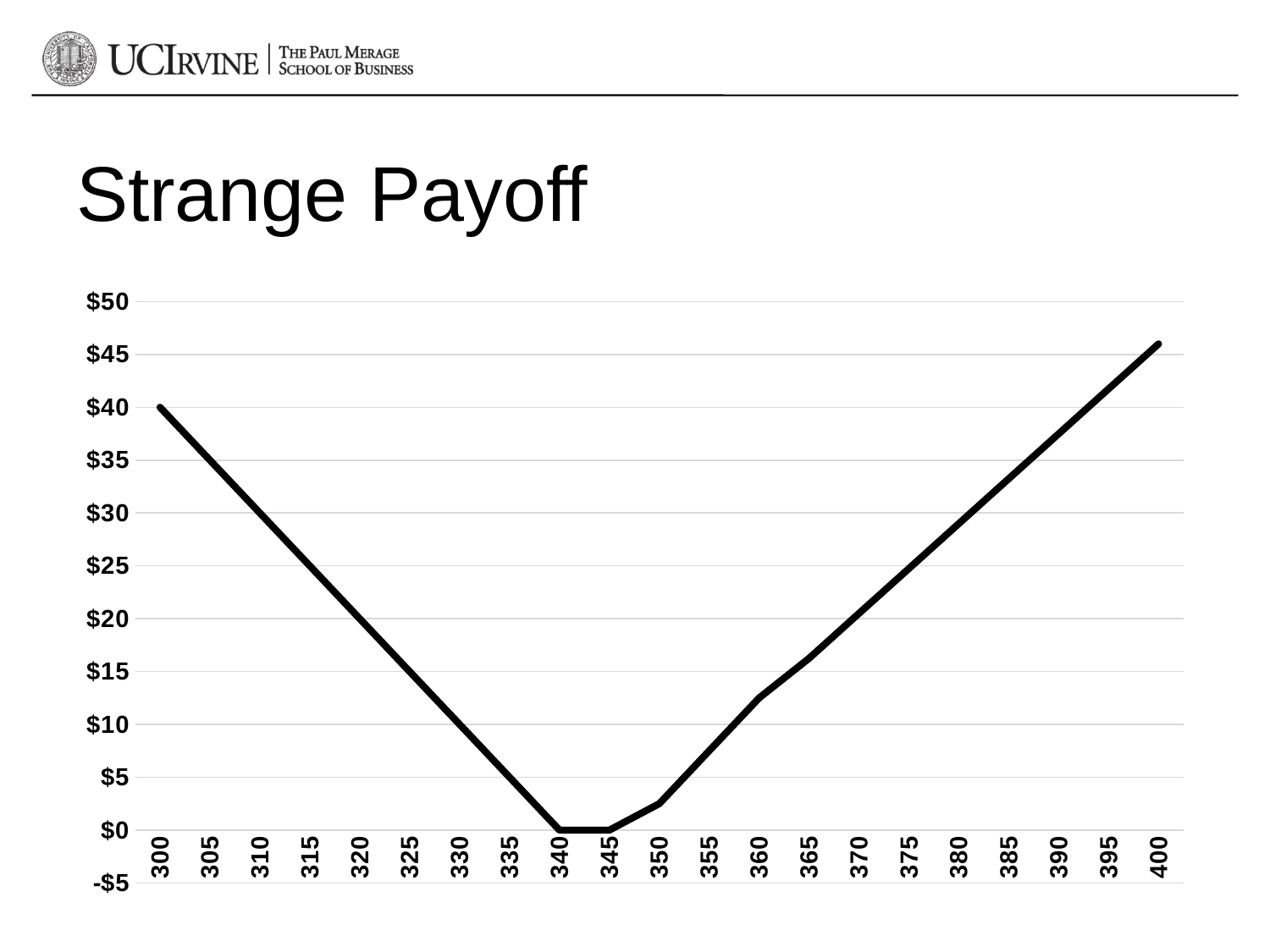
Is the value at 400 greater or less than $45? greater What is the title of the chart? Strange Payoff At which x-axis value does the line reach its highest point? 400 Is the value at 360 greater or less than $10? greater What is the payoff value at 300? $40 Does the line rise or fall between 300 and 340? fall What kind of chart is shown on the slide? line chart What is the difference between the value at 300 and the value at 340? $40 What is the payoff value at 340? $0 Which is larger, the value at 300 or the value at 400? 400 How many x-axis categories are plotted on the chart? 21 Is the value at 350 greater or less than $5? less